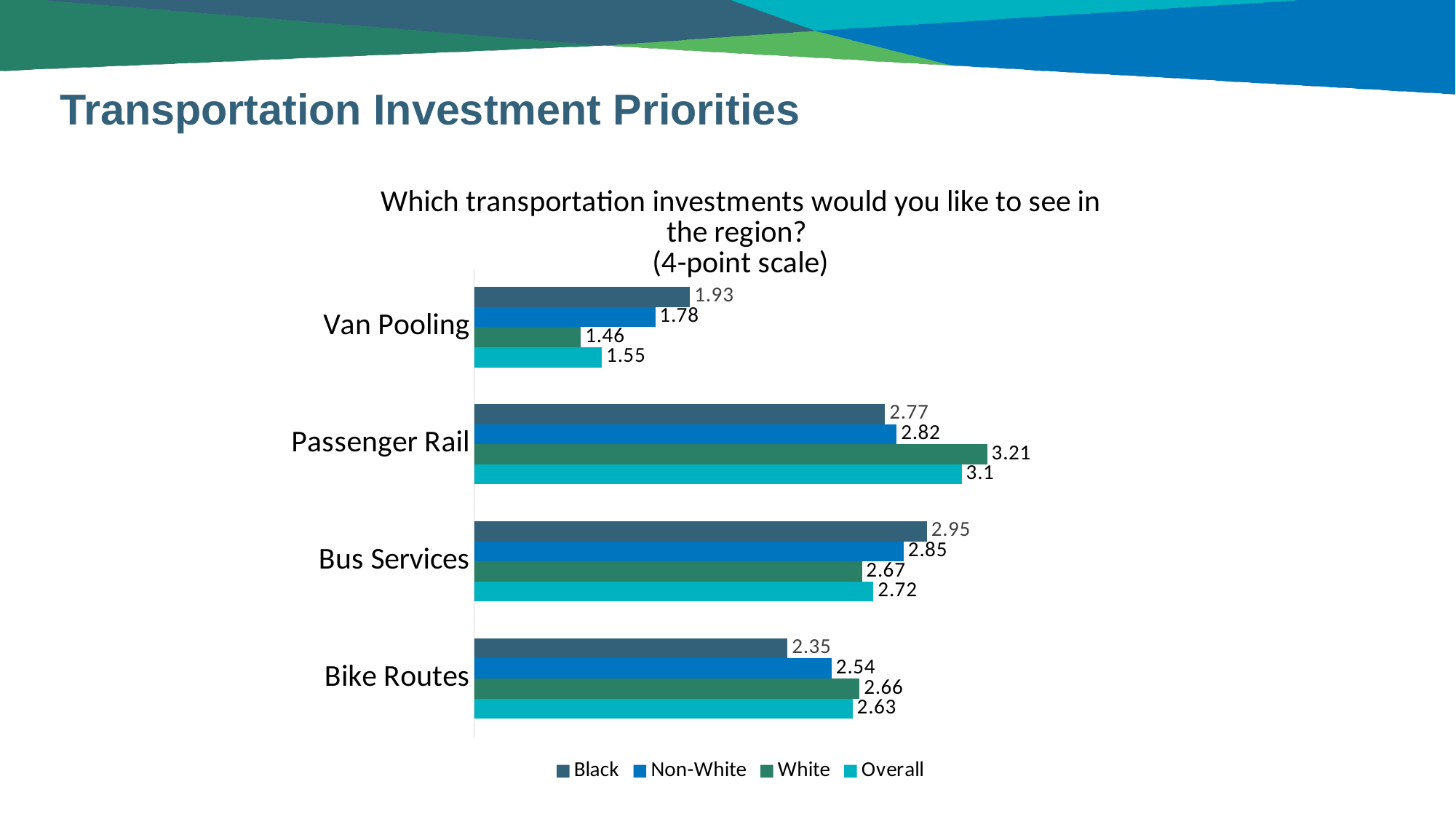
What kind of chart is shown on the slide? Bar chart Which category has the lowest Overall value? Van Pooling How many series does the legend list? 4 Which is larger for Bike Routes, the Black value or the White value? White What is the difference between the White and Black values for Passenger Rail? 0.44 Which series is shown in the darkest blue colour in the legend? Black Which category has the highest White value? Passenger Rail What is the Overall value for Passenger Rail? 3.1 What is the Black value for Bus Services? 2.95 What is the White value for Van Pooling? 1.46 How many categories are shown on the chart? 4 What is the Non-White value for Bike Routes? 2.54